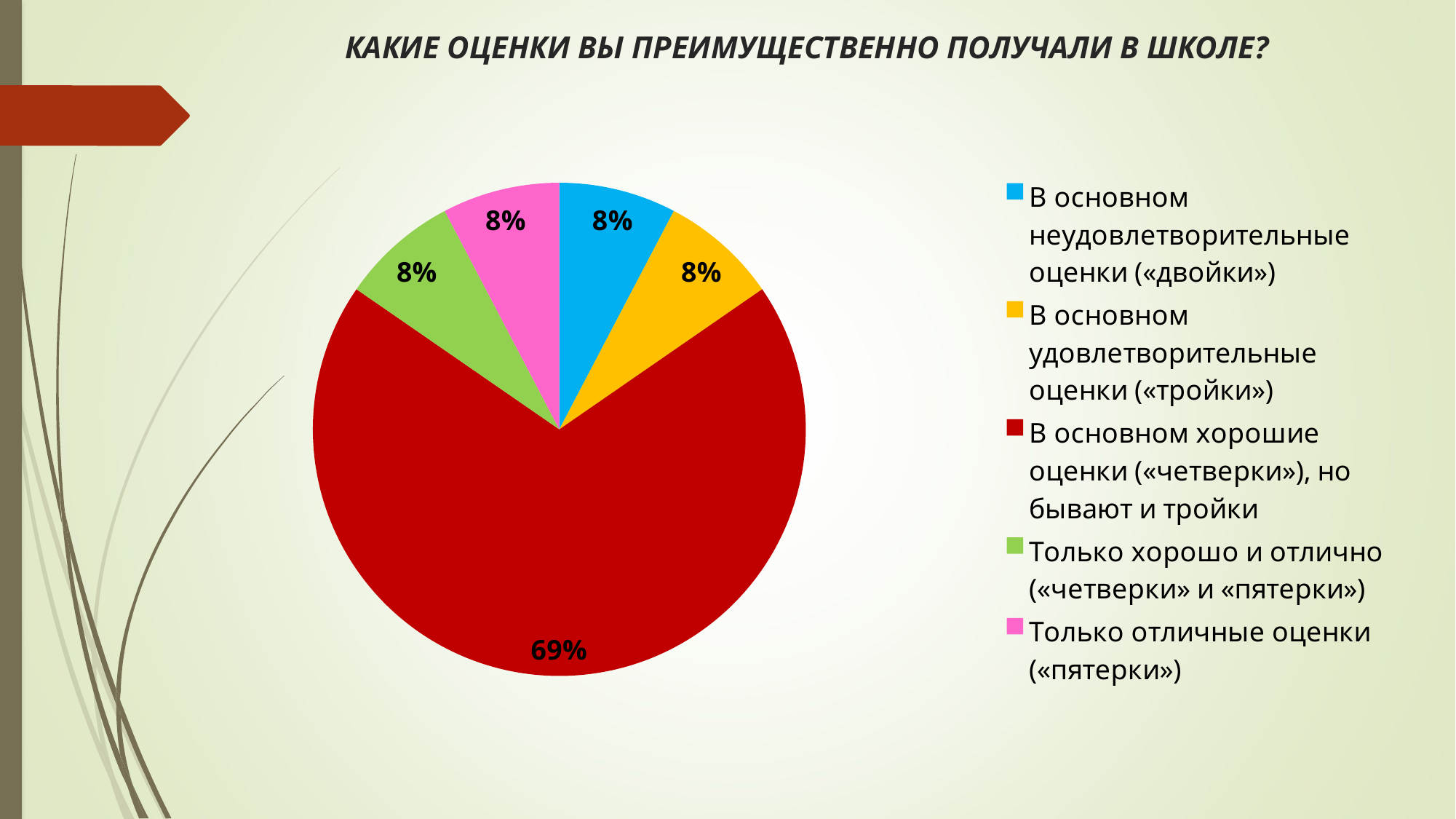
What is the difference between the share for «В основном хорошие оценки («четверки»), но бывают и тройки» and the share for «В основном удовлетворительные оценки («тройки»)»? 61% What is the title of the chart? КАКИЕ ОЦЕНКИ ВЫ ПРЕИМУЩЕСТВЕННО ПОЛУЧАЛИ В ШКОЛЕ? How many categories are listed in the legend? 5 What kind of chart is shown on the slide? pie chart Which category has the largest share of the pie? В основном хорошие оценки («четверки»), но бывают и тройки How many slices does the pie chart have? 5 What is the value for «В основном неудовлетворительные оценки («двойки»)»? 8% What is the value for «Только отличные оценки («пятерки»)»? 8% Which is larger: the share for «В основном хорошие оценки («четверки»), но бывают и тройки» or the share for «Только отличные оценки («пятерки»)»? В основном хорошие оценки («четверки»), но бывают и тройки What colour is the slice for «В основном удовлетворительные оценки («тройки»)»? yellow What is the value for «Только хорошо и отлично («четверки» и «пятерки»)»? 8% What share of the pie is labelled «В основном хорошие оценки («четверки»), но бывают и тройки»? 69%